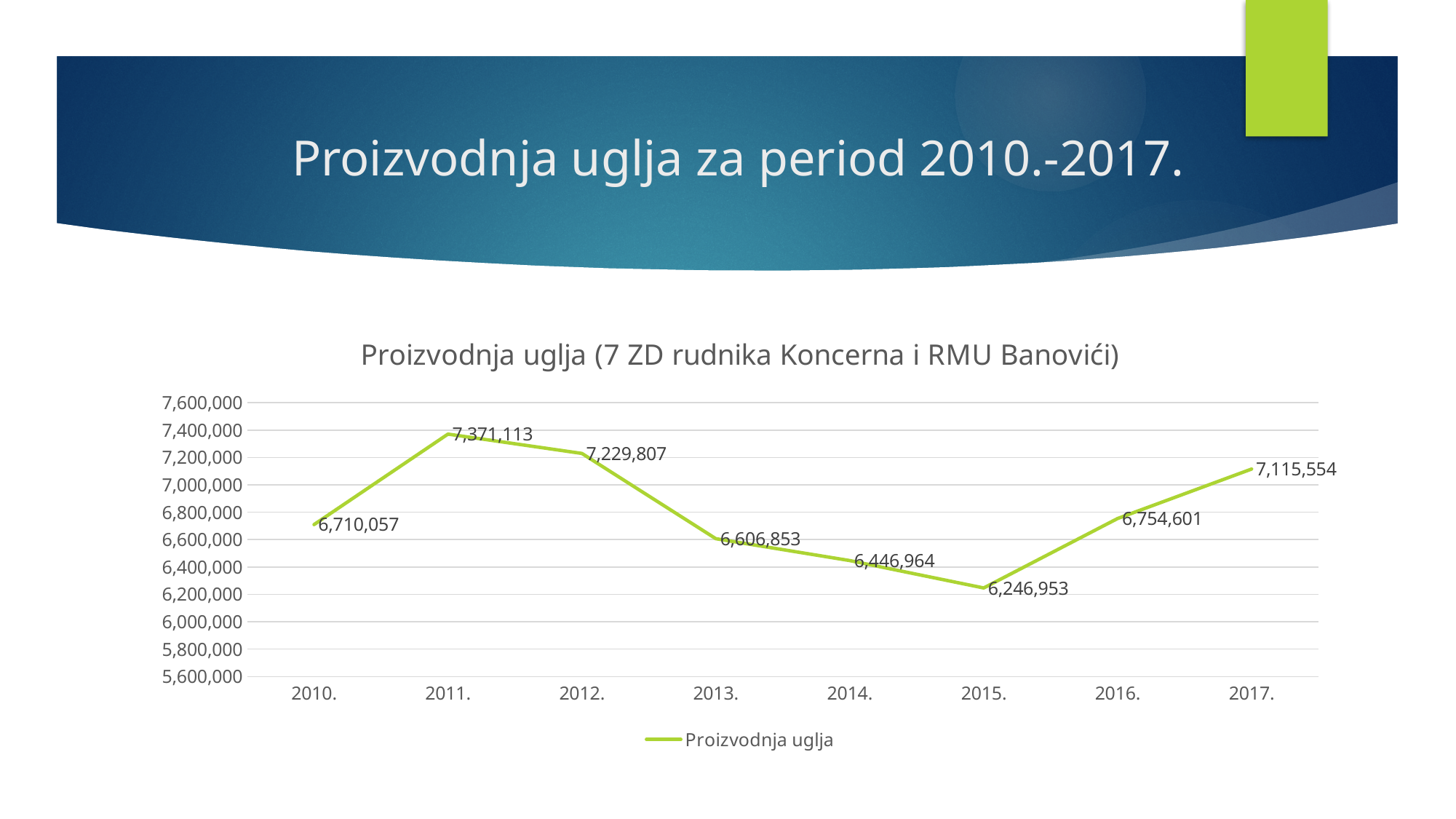
Do the values rise or fall from 2012. to 2015.? fall What is the coal production value for 2017.? 7,115,554 What is the coal production value for 2011.? 7,371,113 What kind of chart is shown? line chart What is the coal production value for 2015.? 6,246,953 What is the difference between the 2011. and 2010. values? 661,056 How many years are plotted on the x axis? 8 How many series does the legend list? 1 Which year has the highest coal production? 2011. Which year has the lowest coal production? 2015. Which is larger, the value for 2012. or the value for 2016.? 2012. What is the difference between the 2017. and 2015. values? 868,601